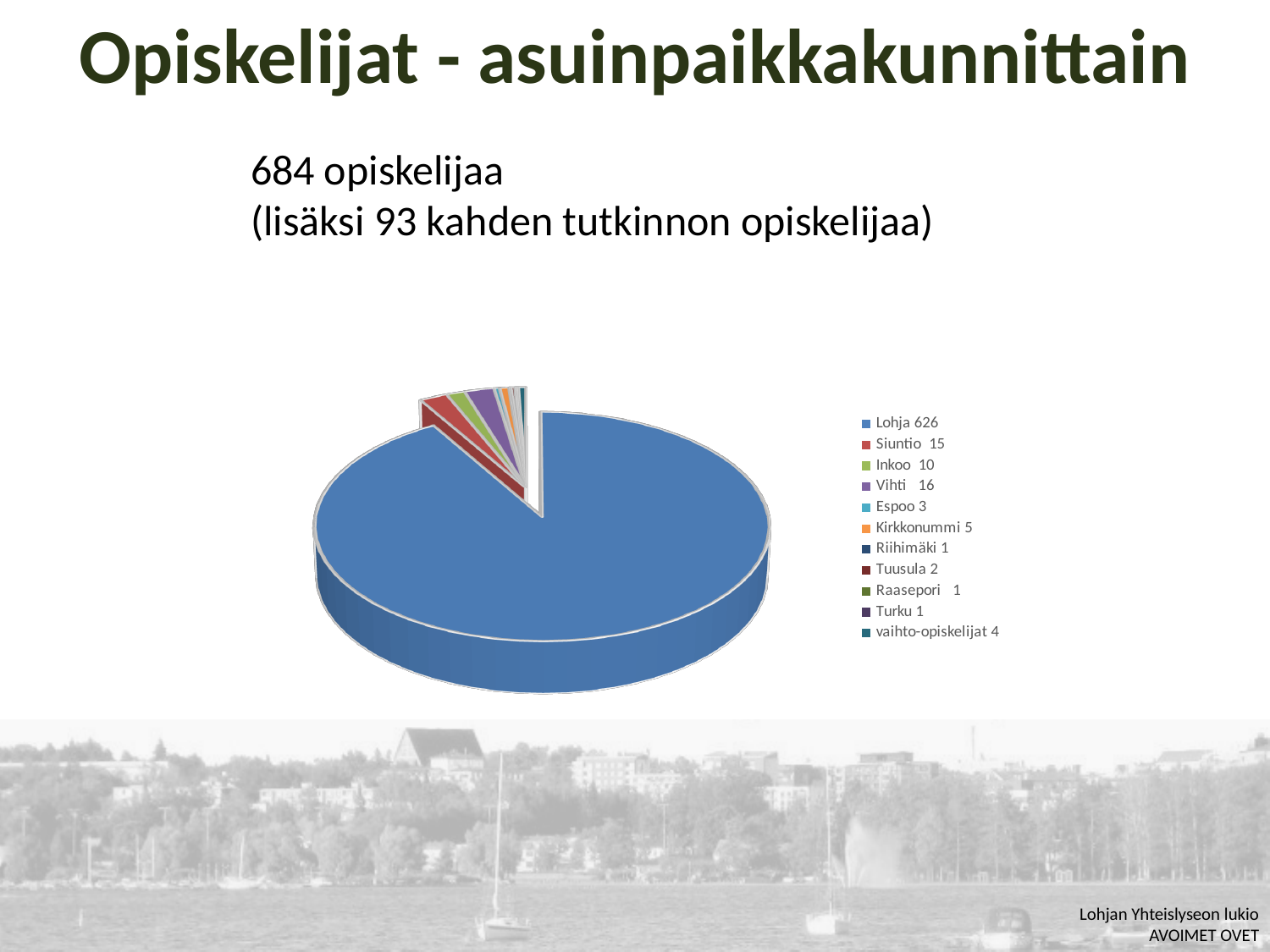
How many students are from Kirkkonummi? 5 Which has more students, Vihti or Siuntio? Vihti How many students are from Siuntio? 15 How many students are from Vihti? 16 How many students are from Lohja according to the legend? 626 What is the difference between the number of students from Lohja and from Vihti? 610 What is the difference between the number of students from Inkoo and from Espoo? 7 What colour is the Lohja slice of the pie? blue Which municipality has the largest slice of the pie? Lohja How many categories does the pie chart's legend list? 11 How many vaihto-opiskelijat (exchange students) are listed in the legend? 4 What kind of chart is shown on the slide? pie chart